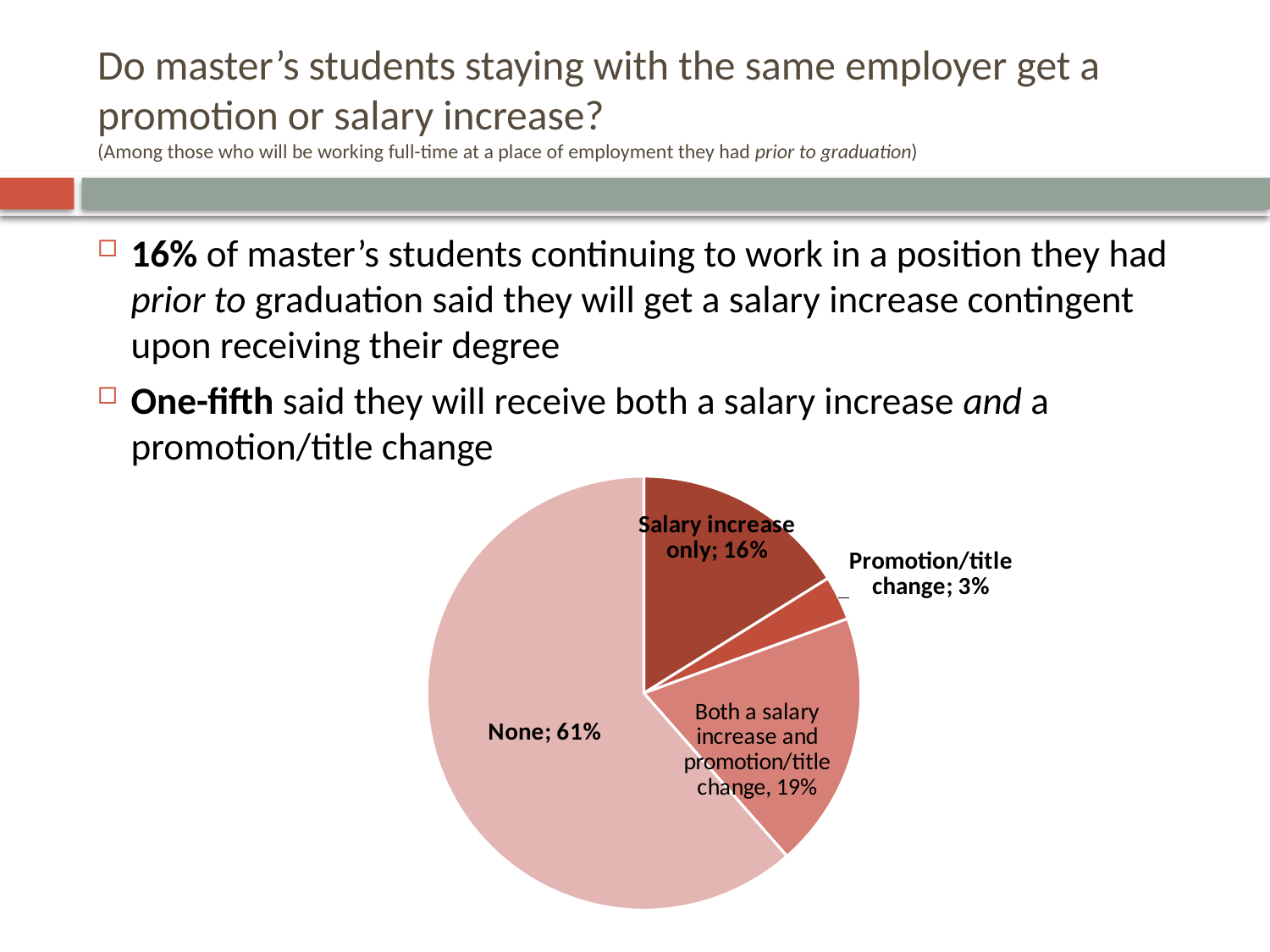
What percentage is shown for "Both a salary increase and promotion/title change"? 19% What is the difference in percentage points between "Salary increase only" and "Promotion/title change"? 13 What percentage is shown for "Promotion/title change"? 3% Which slice of the pie is the smallest? Promotion/title change How many slices does the pie chart have? 4 Which slice of the pie is the largest? None What share of the pie is labelled "None"? 61% What kind of chart is shown on the slide? pie chart Which slice of the pie is the darkest red? Salary increase only What is the difference in percentage points between "None" and "Both a salary increase and promotion/title change"? 42 Which is larger: "Salary increase only" or "Both a salary increase and promotion/title change"? Both a salary increase and promotion/title change What percentage is shown for "Salary increase only"? 16%